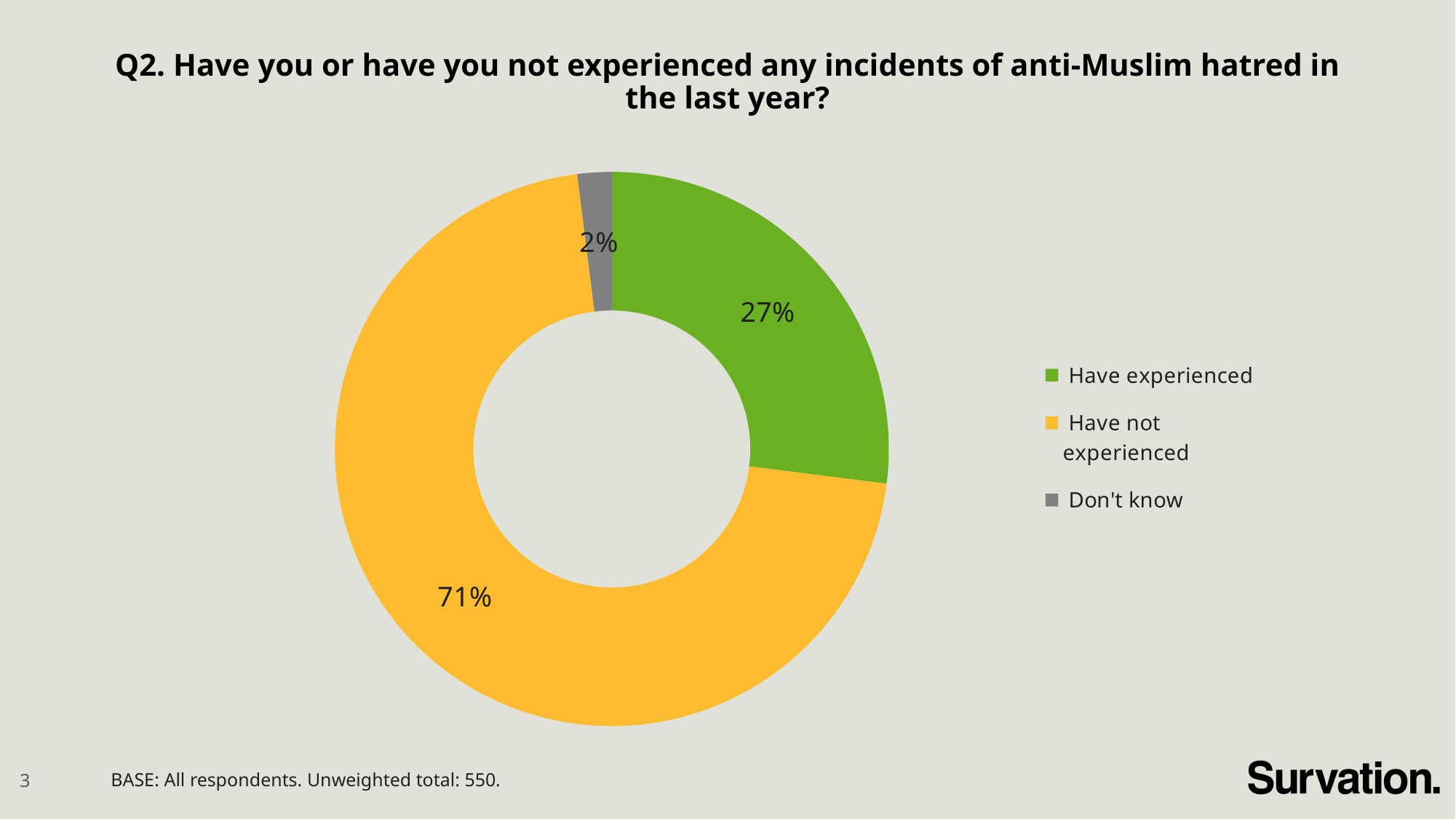
What share of the pie does the 'Have not experienced' slice represent? 71% What colour represents 'Have experienced' in the chart? Green How many response categories are shown in the chart? 3 What percentage of respondents said they have not experienced incidents of anti-Muslim hatred in the last year? 71% What kind of chart is shown on the slide? Pie chart (doughnut) Which response category has the smallest share of the chart? Don't know What percentage of respondents said they have experienced incidents of anti-Muslim hatred in the last year? 27% Which response category has the largest share of the chart? Have not experienced What is the difference in percentage points between 'Have not experienced' and 'Have experienced'? 44 What is the unweighted total number of respondents stated on the slide? 550 Which is larger: the share for 'Have experienced' or the share for 'Don't know'? Have experienced What percentage of respondents answered 'Don't know'? 2%